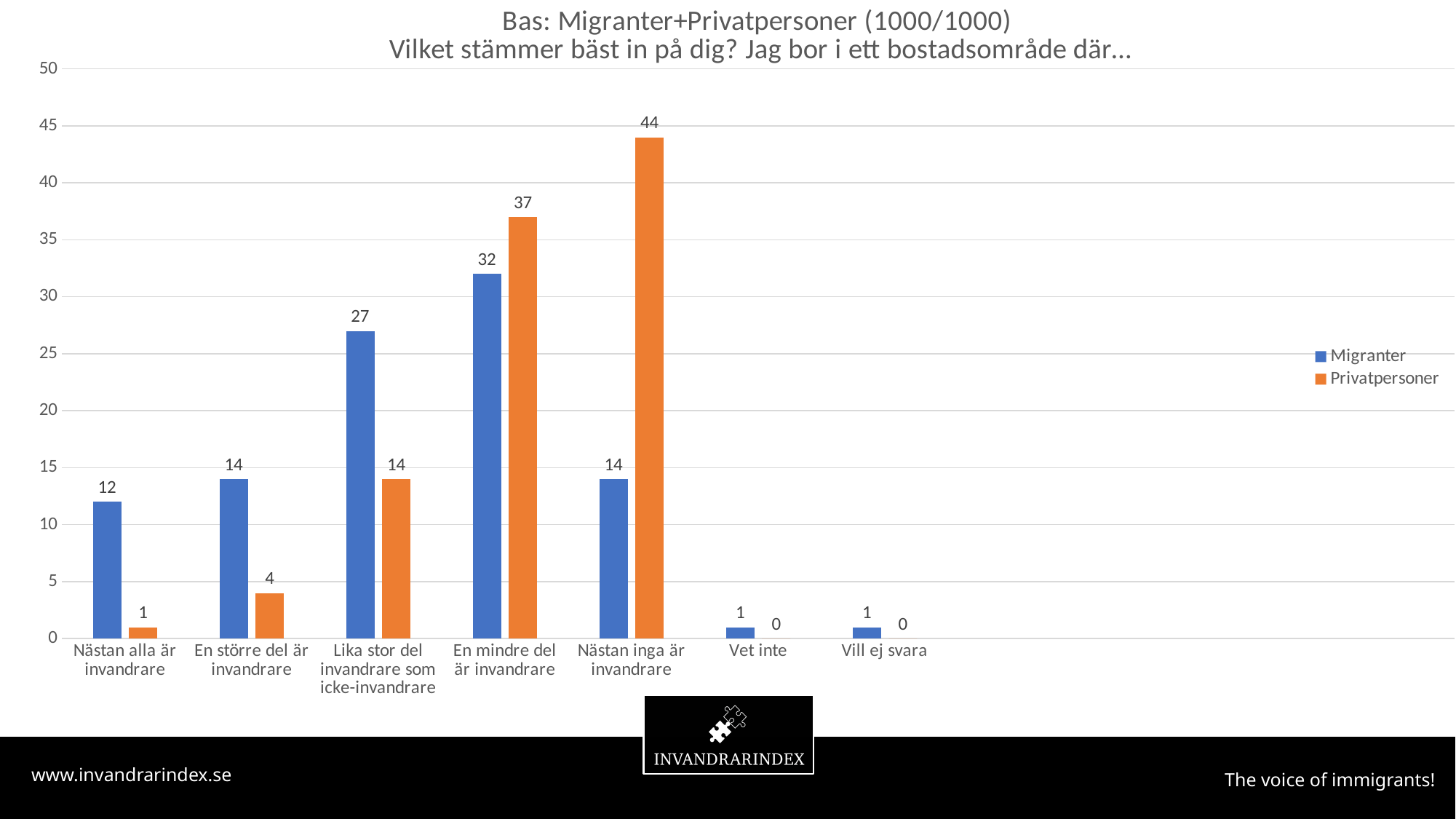
How many categories are shown on the x axis? 7 What is the difference between the Migranter and Privatpersoner values in the category "En större del är invandrare"? 10 What is the value for Privatpersoner in the category "Nästan inga är invandrare"? 44 What is the value for Privatpersoner in the category "Nästan alla är invandrare"? 1 Which category has the highest value for the Migranter series? En mindre del är invandrare What is the value for Migranter in the category "Lika stor del invandrare som icke-invandrare"? 27 How many series does the legend list? 2 What kind of chart is shown on the slide? Bar chart What is the difference between the Privatpersoner and Migranter values in the category "Nästan inga är invandrare"? 30 Which category has the highest value for the Privatpersoner series? Nästan inga är invandrare Which colour represents the Privatpersoner series? Orange In the category "En mindre del är invandrare", which series has the larger value, Migranter or Privatpersoner? Privatpersoner